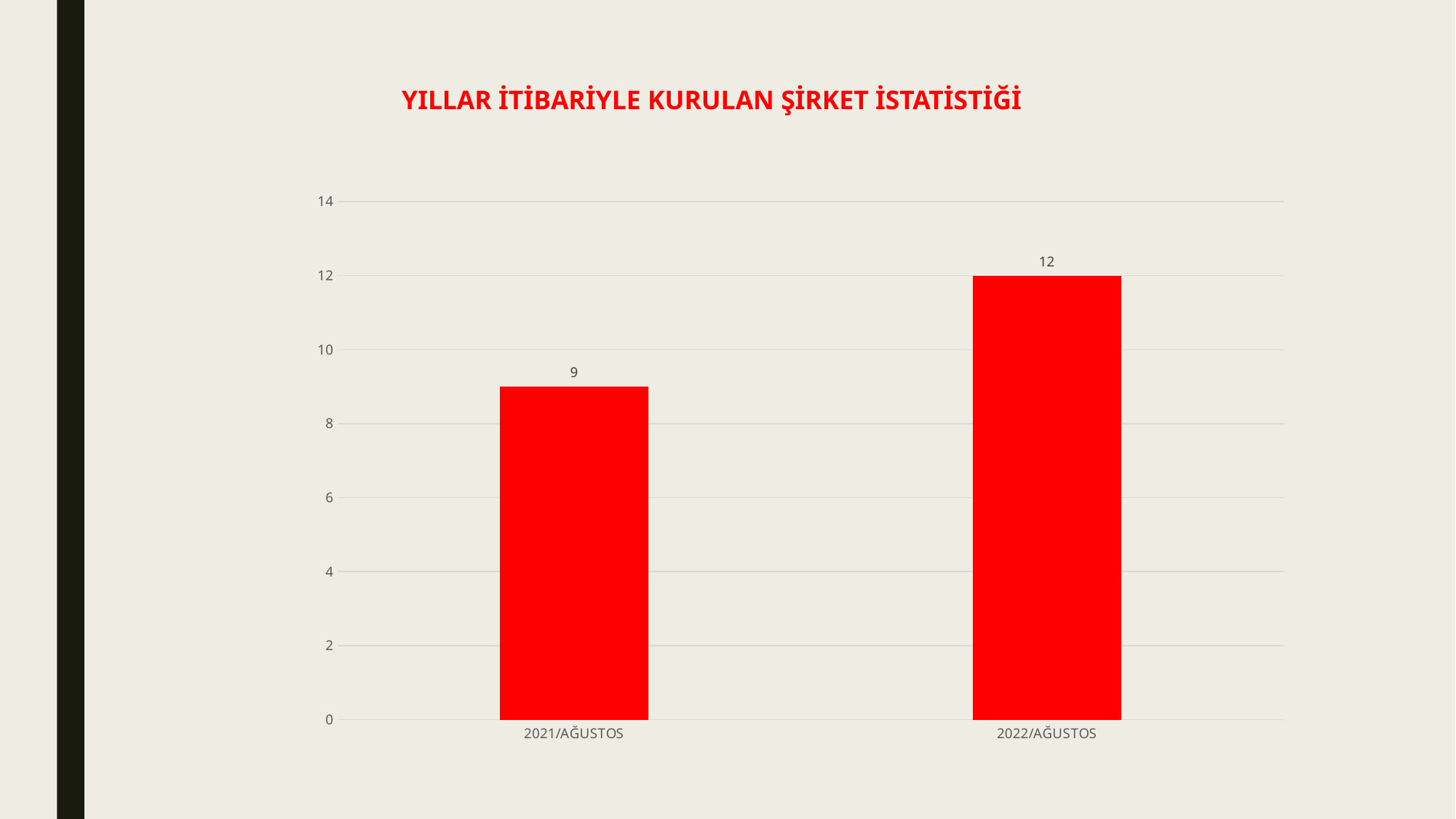
What is the value for 2021/AĞUSTOS? 9 What is the title of the chart? YILLAR İTİBARİYLE KURULAN ŞİRKET İSTATİSTİĞİ What is the difference between the values for 2022/AĞUSTOS and 2021/AĞUSTOS? 3 Which category has the lowest value? 2021/AĞUSTOS Which category has the highest value? 2022/AĞUSTOS What kind of chart is shown on the slide? bar chart How many categories are shown on the x axis? 2 Which is larger, the value for 2021/AĞUSTOS or the value for 2022/AĞUSTOS? 2022/AĞUSTOS Do the values rise or fall from 2021/AĞUSTOS to 2022/AĞUSTOS? rise Is the value for 2021/AĞUSTOS greater or less than 10? less Is the value for 2022/AĞUSTOS greater or less than 10? greater What is the value for 2022/AĞUSTOS? 12